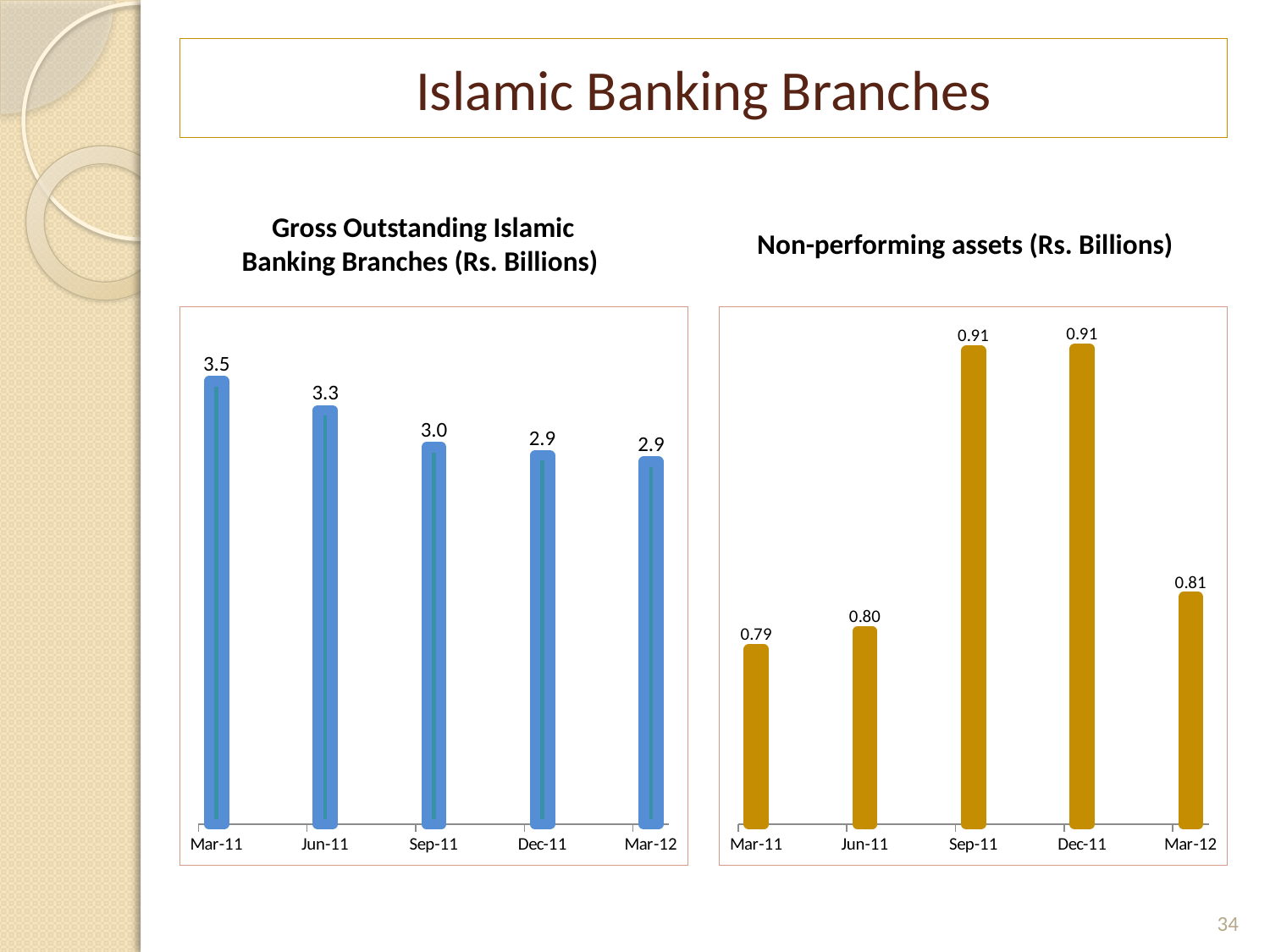
In the 'Non-performing assets (Rs. Billions)' chart, what is the value for Jun-11? 0.80 In the 'Non-performing assets (Rs. Billions)' chart, what is the value for Mar-12? 0.81 In the 'Gross Outstanding Islamic Banking Branches (Rs. Billions)' chart, how many periods are shown? 5 In the 'Gross Outstanding Islamic Banking Branches (Rs. Billions)' chart, do the values rise or fall from Mar-11 to Mar-12? fall In the 'Non-performing assets (Rs. Billions)' chart, which period has the lowest value? Mar-11 In the 'Gross Outstanding Islamic Banking Branches (Rs. Billions)' chart, which period has the highest value? Mar-11 In the 'Gross Outstanding Islamic Banking Branches (Rs. Billions)' chart, what is the value for Mar-11? 3.5 In the 'Gross Outstanding Islamic Banking Branches (Rs. Billions)' chart, what is the difference between the Mar-11 and Mar-12 values? 0.6 What kind of chart is the 'Non-performing assets (Rs. Billions)' chart? bar chart In the 'Non-performing assets (Rs. Billions)' chart, what is the difference between the Dec-11 and Mar-12 values? 0.10 In the 'Gross Outstanding Islamic Banking Branches (Rs. Billions)' chart, what is the value for Sep-11? 3.0 In the 'Non-performing assets (Rs. Billions)' chart, which is larger, the value for Sep-11 or the value for Jun-11? Sep-11